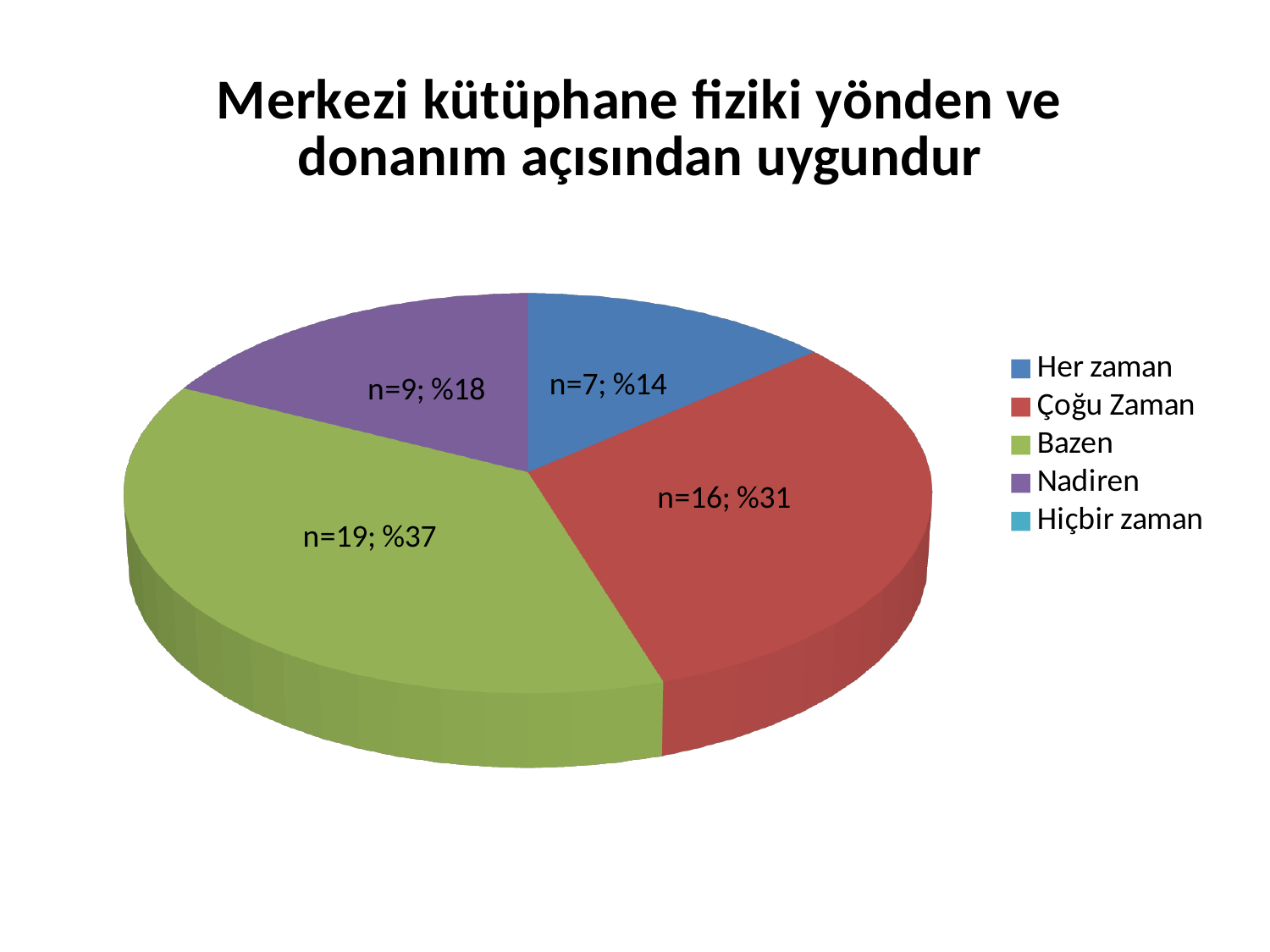
What is the value shown for the Her zaman slice? n=7; %14 Which category has the largest slice of the pie? Bazen What is the value shown for the Nadiren slice? n=9; %18 What percentage share of the pie does the Bazen slice have? %37 What is the value shown for the Çoğu Zaman slice? n=16; %31 Which is larger, the Nadiren slice or the Her zaman slice? Nadiren What is the value shown for the Bazen slice? n=19; %37 What kind of chart is shown on the slide? pie chart What colour is the Bazen slice? green What is the difference in n between the Bazen and Çoğu Zaman slices? 3 How many entries does the legend list? 5 Which of the labelled slices is the smallest? Her zaman